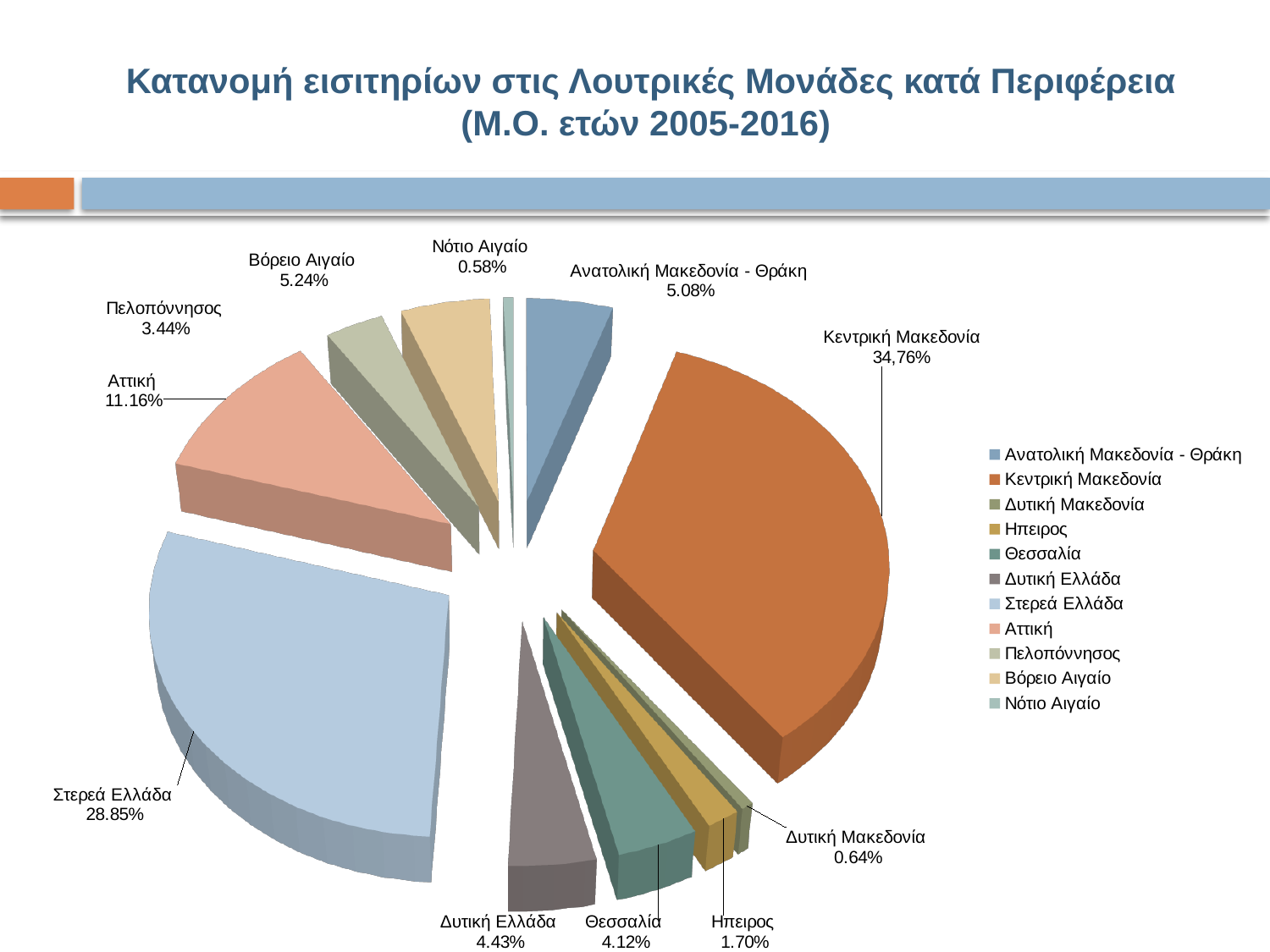
What kind of chart is shown on the slide? Pie chart What percentage is shown for Αττική? 11.16% Which has a larger share, Αττική or Βόρειο Αιγαίο? Αττική Which region has the largest share of the pie? Κεντρική Μακεδονία How many regions (slices) are shown in the pie chart? 11 How many entries does the legend list? 11 What percentage is shown for Κεντρική Μακεδονία? 34,76% What percentage is shown for Στερεά Ελλάδα? 28.85% What is the difference in percentage points between Βόρειο Αιγαίο and Πελοπόννησος? 1.80% Which region has the smallest share of the pie? Νότιο Αιγαίο What is the difference in percentage points between Στερεά Ελλάδα and Αττική? 17.69% What percentage is shown for Ήπειρος? 1.70%